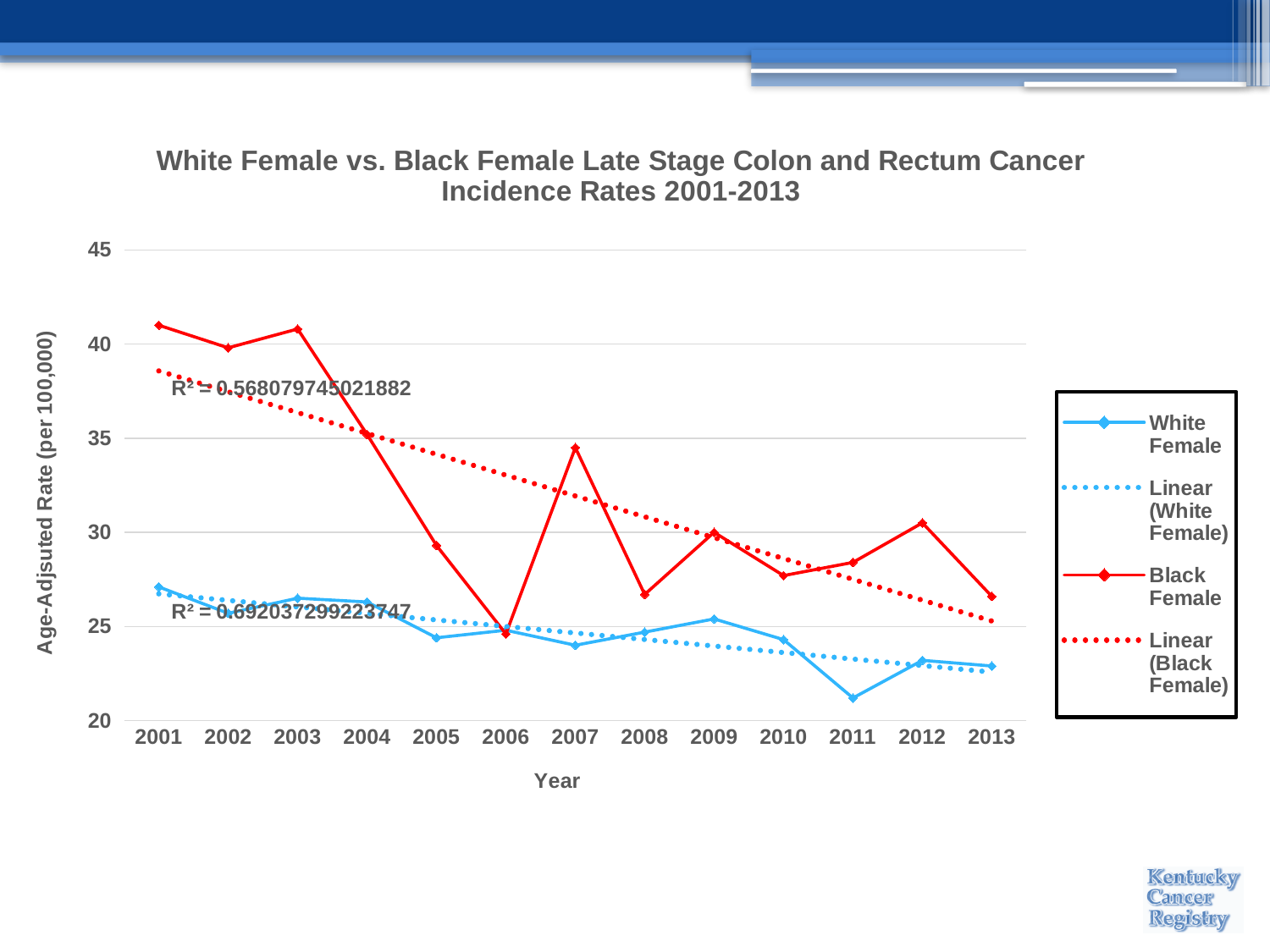
Is the Black Female value for 2001 greater or less than 40? greater In which year is the Black Female rate lowest? 2006 How many years are plotted along the x axis? 13 In which year is the White Female rate lowest? 2011 How many entries does the legend list? 4 Is the White Female value for 2011 greater or less than 25? less Which series has the larger value in 2001, White Female or Black Female? Black Female Is the Black Female value for 2008 greater or less than 30? less Do the Black Female rates generally rise or fall from 2001 to 2013? Fall What is the label of the y axis? Age-Adjusted Rate (per 100,000) What R² value is shown for the Black Female linear trendline? 0.568079745021882 What kind of chart is shown on the slide? Line chart